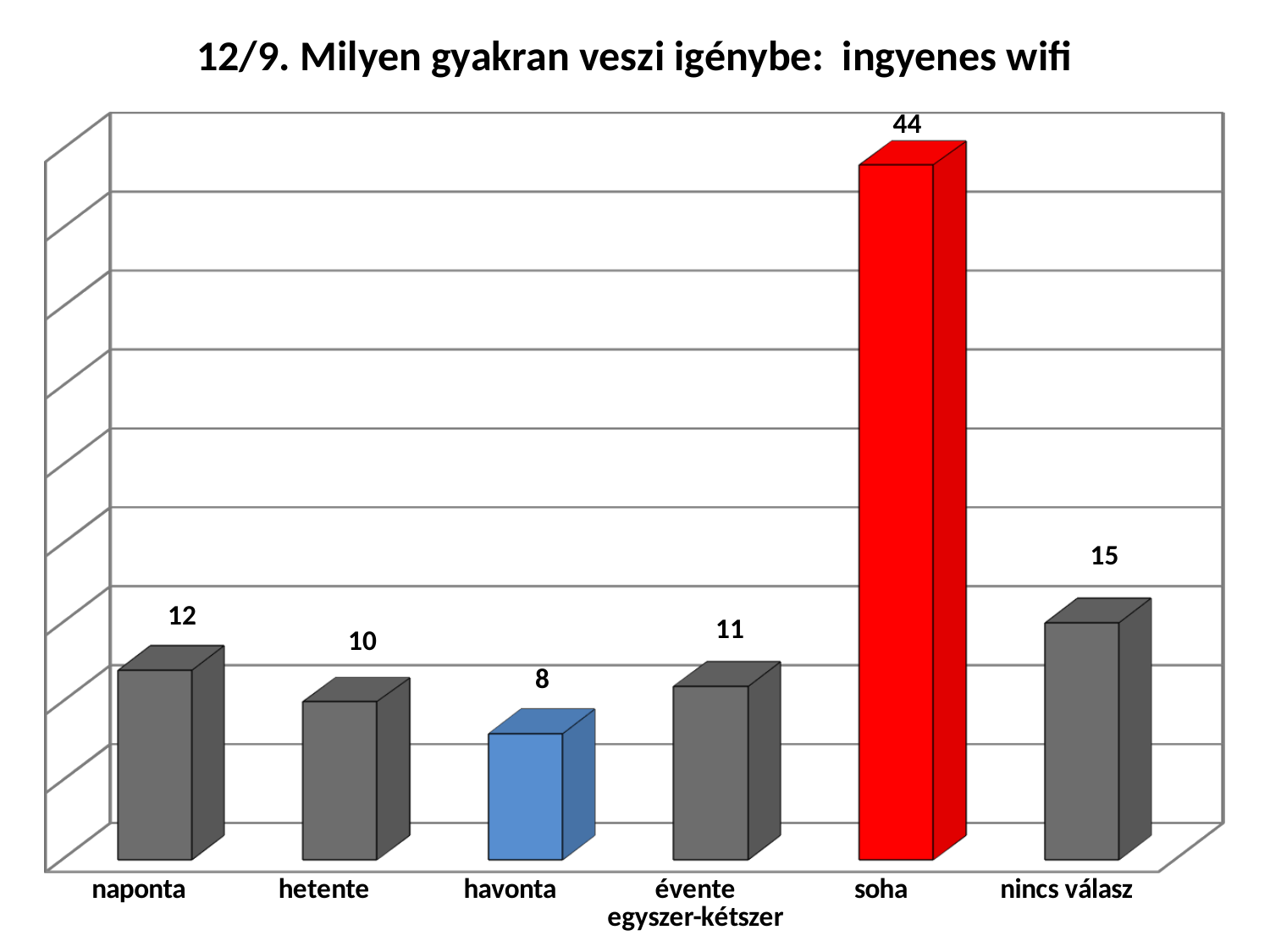
Which is larger, the value for "naponta" or the value for "évente egyszer-kétszer"? naponta How many categories are shown on the x axis? 6 What is the difference between the values for "soha" and "nincs válasz"? 29 What is the value for "évente egyszer-kétszer"? 11 Which category has the lowest value? havonta What kind of chart is this? bar chart What is the value for "soha"? 44 What is the value for "havonta"? 8 What is the value for "nincs válasz"? 15 What is the difference between the values for "naponta" and "hetente"? 2 Which category has the highest value? soha What colour is the bar for "soha"? red